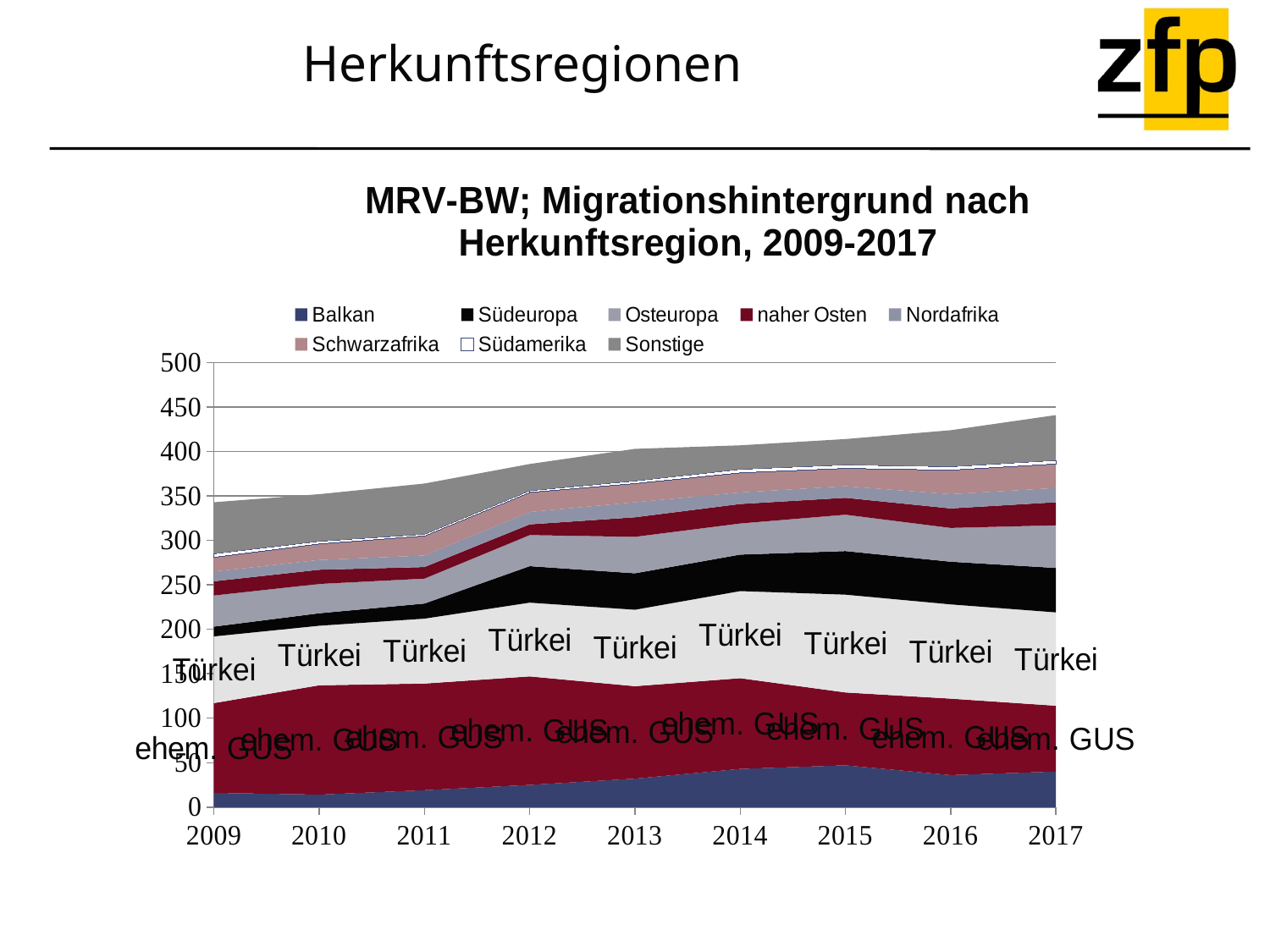
Is the total for 2009 greater or less than 300? greater Is the total for 2017 greater or less than 400? greater What is the title of the chart? MRV-BW; Migrationshintergrund nach Herkunftsregion, 2009-2017 How many years are shown on the x axis? 9 Does the total across all regions rise or fall from 2009 to 2017? rise Which is larger, the total for 2017 or the total for 2009? 2017 How many series does the legend list? 8 Is the total for 2009 greater or less than 400? less Which year has the lowest total across all regions? 2009 Which year has the highest total across all regions? 2017 What kind of chart is shown on the slide? stacked area chart